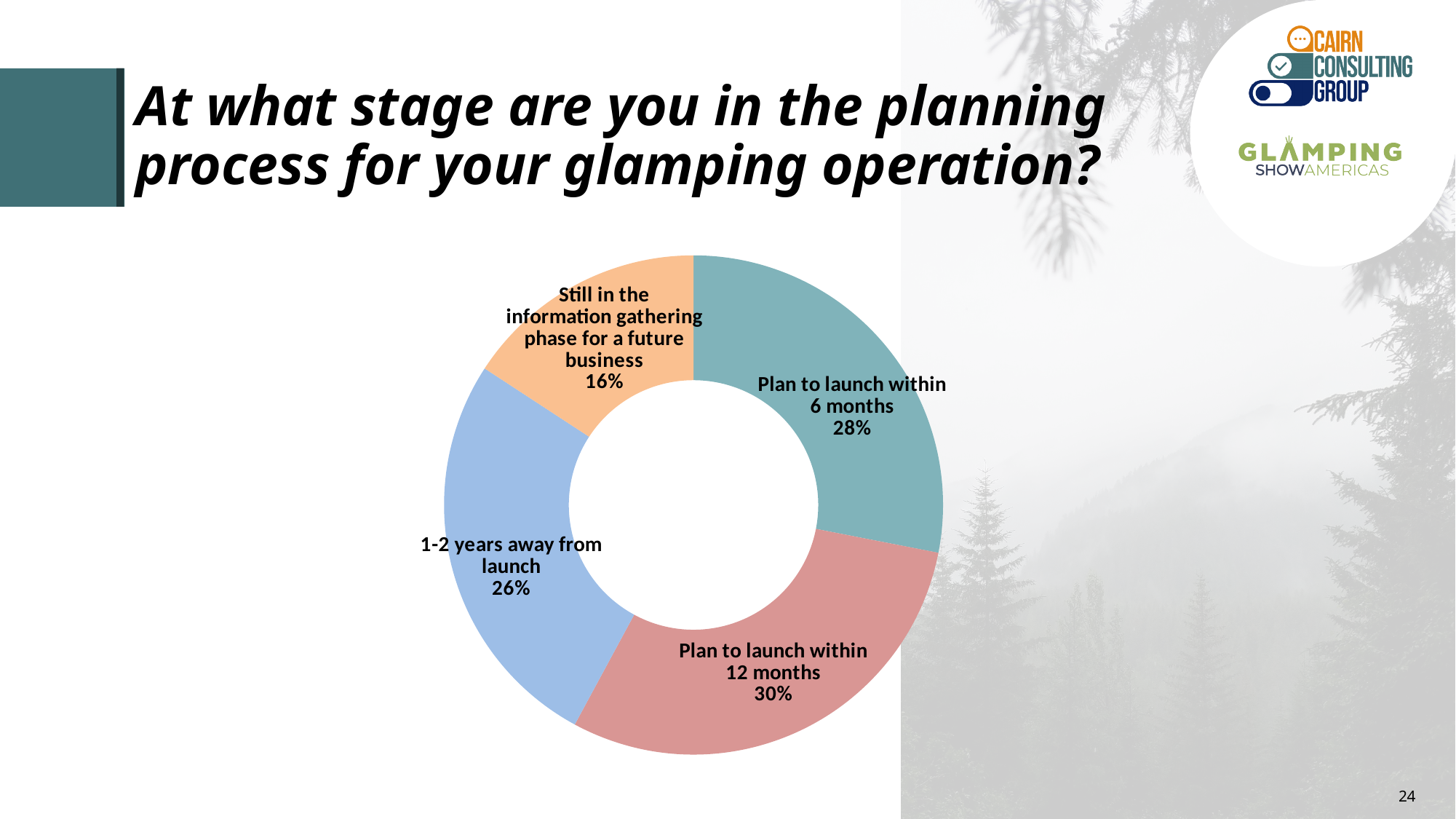
What percentage of respondents plan to launch within 12 months? 30% How many planning stage categories are shown in the chart? 4 What colour is the slice for 'Plan to launch within 12 months'? Red (pink) What is the difference in percentage points between those planning to launch within 6 months and those 1-2 years away from launch? 2 Which planning stage has the smallest share of respondents? Still in the information gathering phase for a future business What is the difference in percentage points between those planning to launch within 12 months and those still in the information gathering phase? 14 What percentage of respondents plan to launch within 6 months? 28% What type of chart is shown on the slide? Pie chart (doughnut) Which planning stage has the largest share of respondents? Plan to launch within 12 months What percentage of respondents are still in the information gathering phase for a future business? 16% Which is larger: the share planning to launch within 6 months or the share 1-2 years away from launch? Plan to launch within 6 months What percentage of respondents are 1-2 years away from launch? 26%